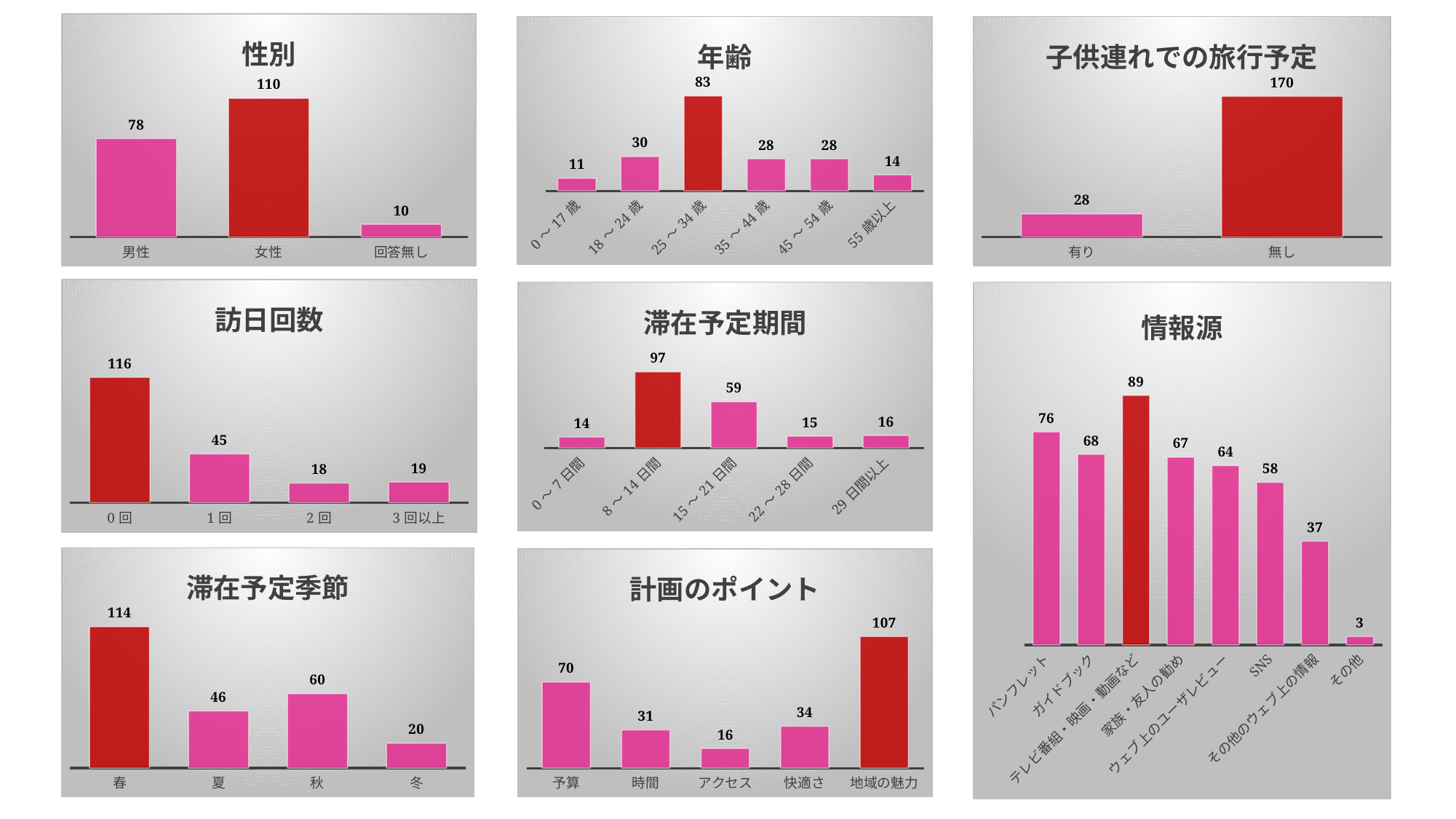
In the 計画のポイント chart, what is the value for 地域の魅力? 107 In the 滞在予定季節 chart, which is larger, 夏 or 秋? 秋 In the 計画のポイント chart, what is the difference between 予算 and 時間? 39 In the 年齢 chart, which age group has the highest value? 25～34歳 How many charts are on the slide? 8 What kind of chart is the 年齢 chart? bar chart In the 情報源 chart, which source has the highest value? テレビ番組・映画・動画など In the 滞在予定期間 chart, how many categories are shown? 5 In the 訪日回数 chart, which category has the lowest value? 2回 In the 情報源 chart, what is the value for SNS? 58 In the 子供連れでの旅行予定 chart, what is the difference between 無し and 有り? 142 In the 性別 chart, what is the value for 女性? 110